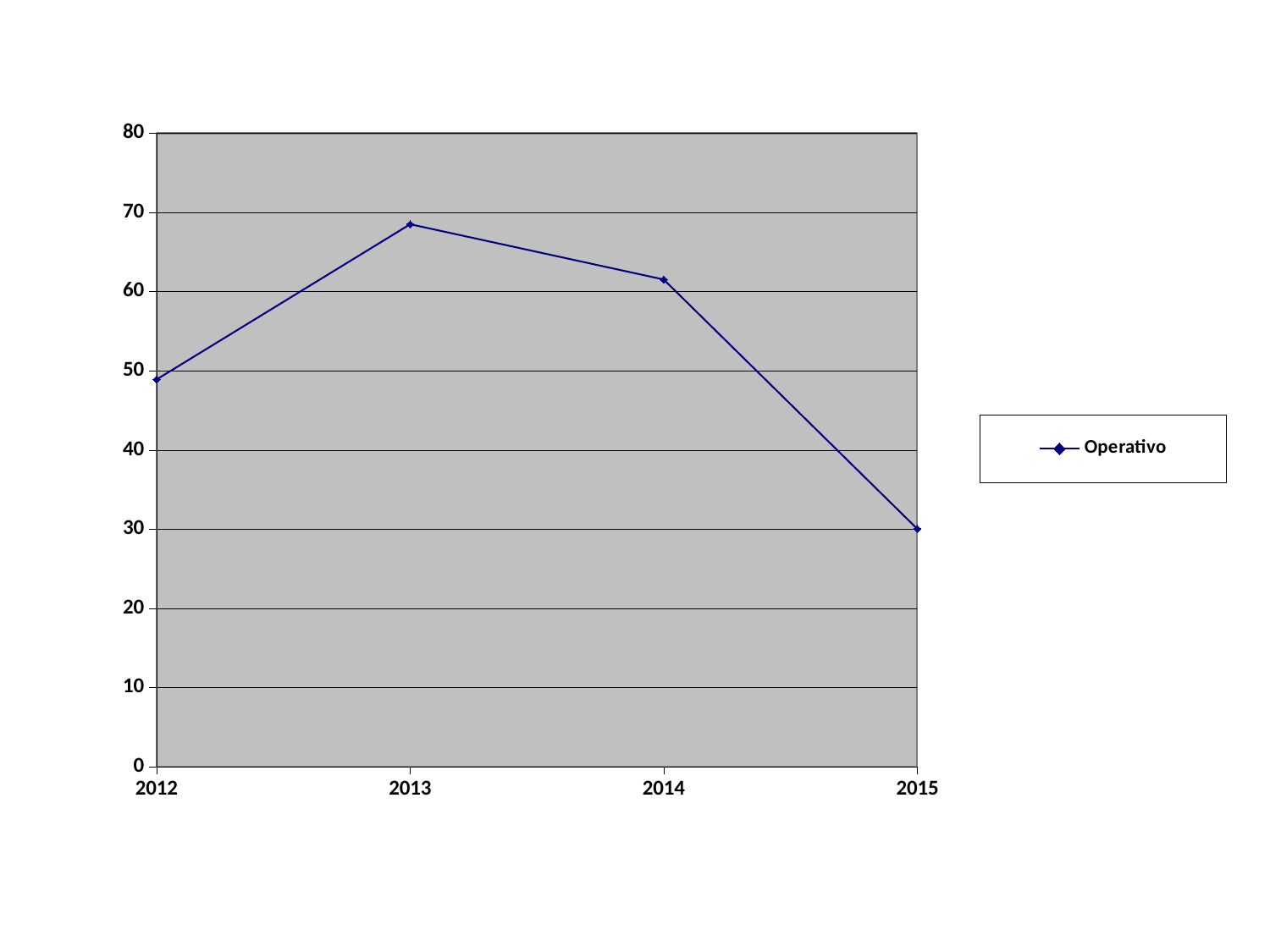
What kind of chart is shown on the slide? line chart In which year is the Operativo value lowest? 2015 Is the Operativo value for 2015 greater or less than 40? less How many years are plotted on the x axis? 4 Which year has the larger Operativo value, 2013 or 2014? 2013 Is the Operativo value for 2014 greater or less than 70? less In which year is the Operativo value highest? 2013 What is the name of the series shown in the legend? Operativo Is the Operativo value for 2013 greater or less than 60? greater Does the Operativo value rise or fall from 2013 to 2015? fall Which year has the larger Operativo value, 2012 or 2015? 2012 How many series does the legend list? 1